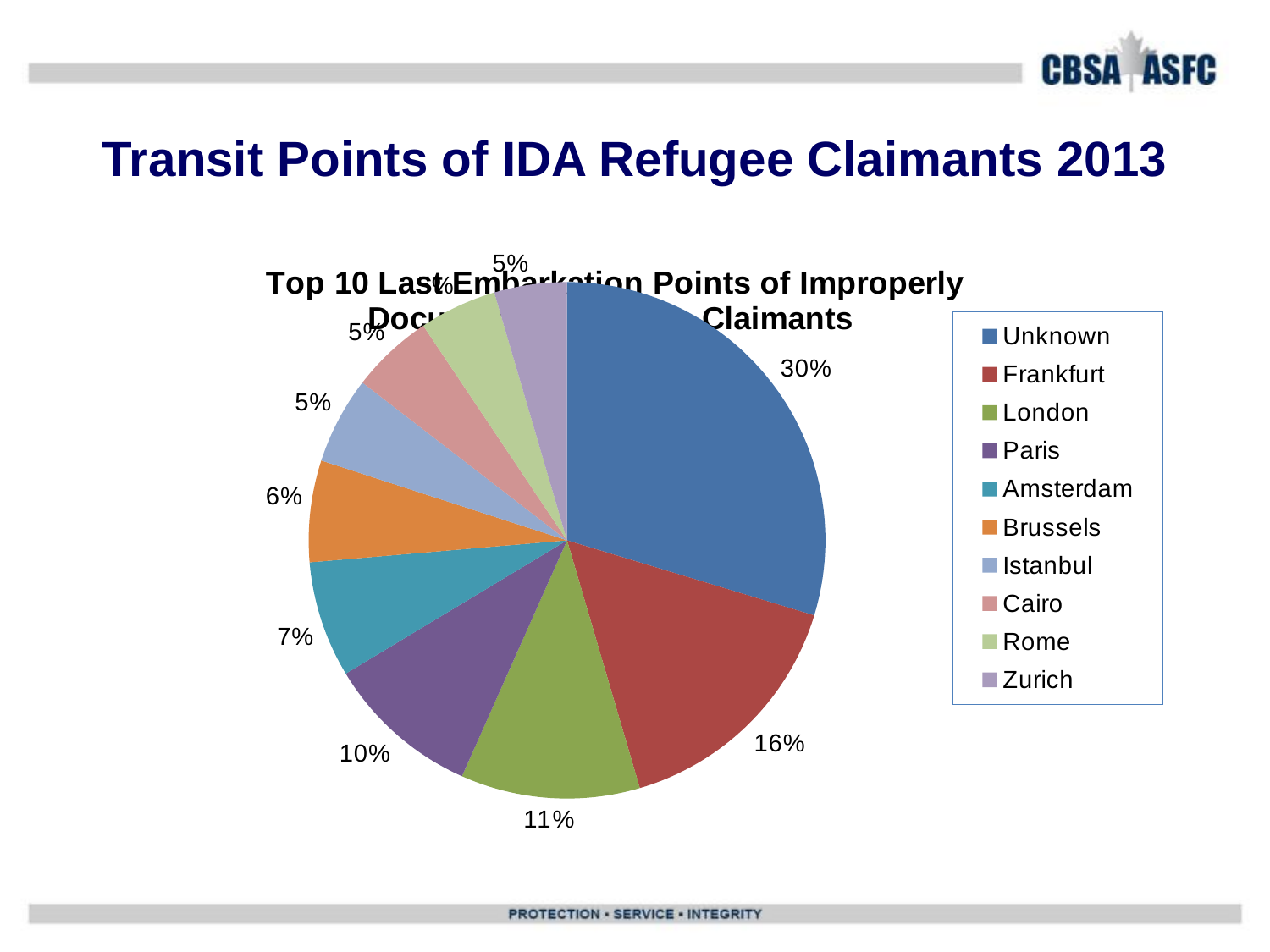
What kind of chart is shown on the slide? pie chart What is the value shown for Brussels? 6% What colour is the slice for Unknown? blue What is the value shown for London? 11% What is the value shown for Paris? 10% What share of the pie does Unknown account for? 30% How many categories does the legend list? 10 By how many percentage points does Unknown exceed Frankfurt? 14 percentage points Which is larger, the slice for Paris or the slice for Amsterdam? Paris Which category has the largest slice of the pie? Unknown What is the value shown for Amsterdam? 7% What is the value shown for Frankfurt? 16%